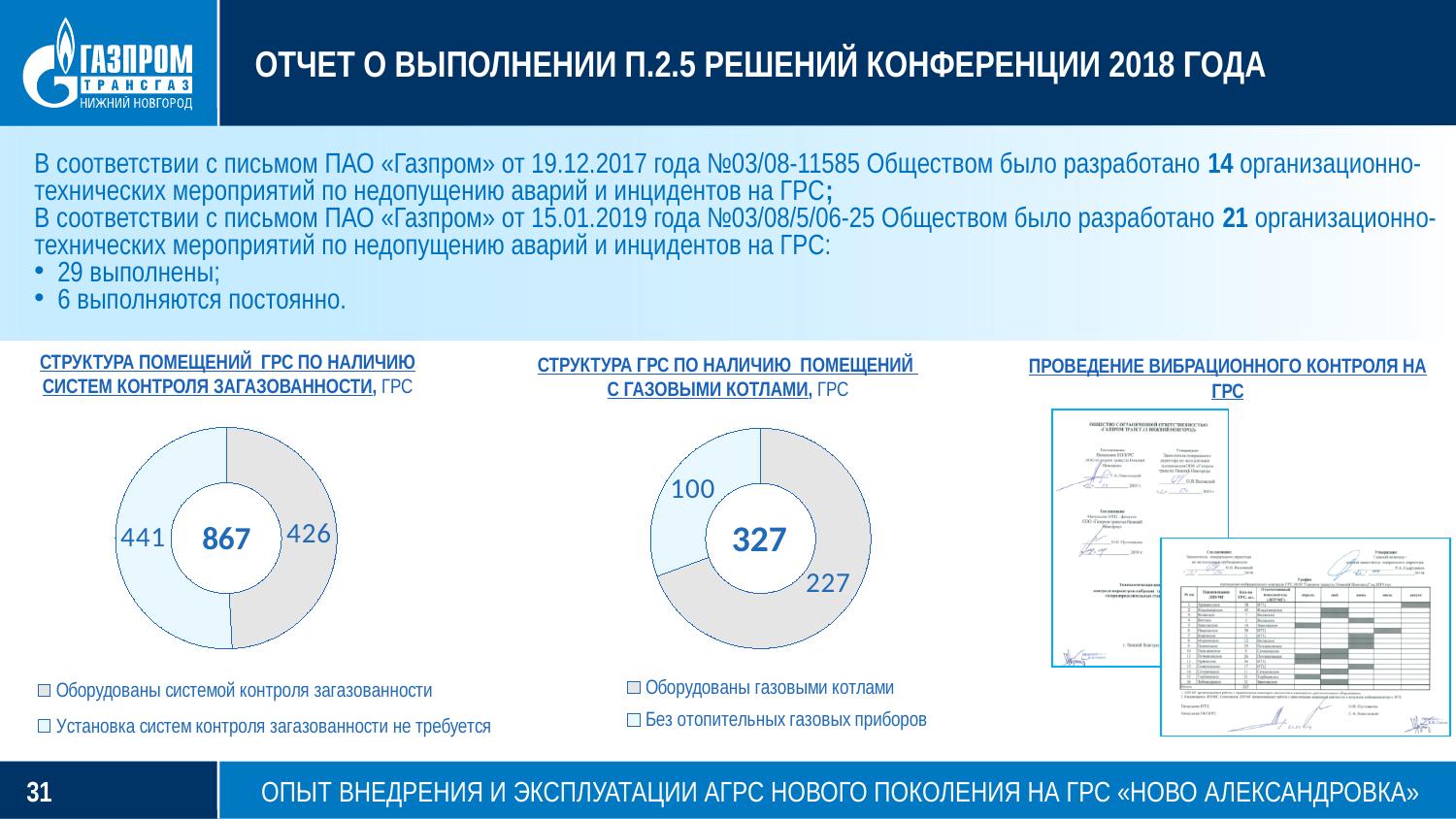
In the left chart «СТРУКТУРА ПОМЕЩЕНИЙ ГРС ПО НАЛИЧИЮ СИСТЕМ КОНТРОЛЯ ЗАГАЗОВАННОСТИ», what is the value for «Оборудованы системой контроля загазованности»? 426 In the left chart «СТРУКТУРА ПОМЕЩЕНИЙ ГРС ПО НАЛИЧИЮ СИСТЕМ КОНТРОЛЯ ЗАГАЗОВАННОСТИ», what is the value for «Установка систем контроля загазованности не требуется»? 441 In the middle chart «СТРУКТУРА ГРС ПО НАЛИЧИЮ ПОМЕЩЕНИЙ С ГАЗОВЫМИ КОТЛАМИ», what is the difference between the slices 227 and 100? 127 In the middle chart «СТРУКТУРА ГРС ПО НАЛИЧИЮ ПОМЕЩЕНИЙ С ГАЗОВЫМИ КОТЛАМИ», what is the value for «Оборудованы газовыми котлами»? 227 In the middle chart «СТРУКТУРА ГРС ПО НАЛИЧИЮ ПОМЕЩЕНИЙ С ГАЗОВЫМИ КОТЛАМИ», which slice is larger: «Оборудованы газовыми котлами» or «Без отопительных газовых приборов»? Оборудованы газовыми котлами In the left chart «СТРУКТУРА ПОМЕЩЕНИЙ ГРС ПО НАЛИЧИЮ СИСТЕМ КОНТРОЛЯ ЗАГАЗОВАННОСТИ», what total value is shown in the centre of the doughnut? 867 In the middle chart «СТРУКТУРА ГРС ПО НАЛИЧИЮ ПОМЕЩЕНИЙ С ГАЗОВЫМИ КОТЛАМИ», what total value is shown in the centre of the doughnut? 327 How many doughnut charts are shown on the slide? 2 What type of chart is used in the left chart titled «СТРУКТУРА ПОМЕЩЕНИЙ ГРС ПО НАЛИЧИЮ СИСТЕМ КОНТРОЛЯ ЗАГАЗОВАННОСТИ»? Doughnut chart In the middle chart «СТРУКТУРА ГРС ПО НАЛИЧИЮ ПОМЕЩЕНИЙ С ГАЗОВЫМИ КОТЛАМИ», what is the value for «Без отопительных газовых приборов»? 100 How many legend entries does the left chart «СТРУКТУРА ПОМЕЩЕНИЙ ГРС ПО НАЛИЧИЮ СИСТЕМ КОНТРОЛЯ ЗАГАЗОВАННОСТИ» list? 2 In the left chart «СТРУКТУРА ПОМЕЩЕНИЙ ГРС ПО НАЛИЧИЮ СИСТЕМ КОНТРОЛЯ ЗАГАЗОВАННОСТИ», what is the difference between the two slices, 441 and 426? 15